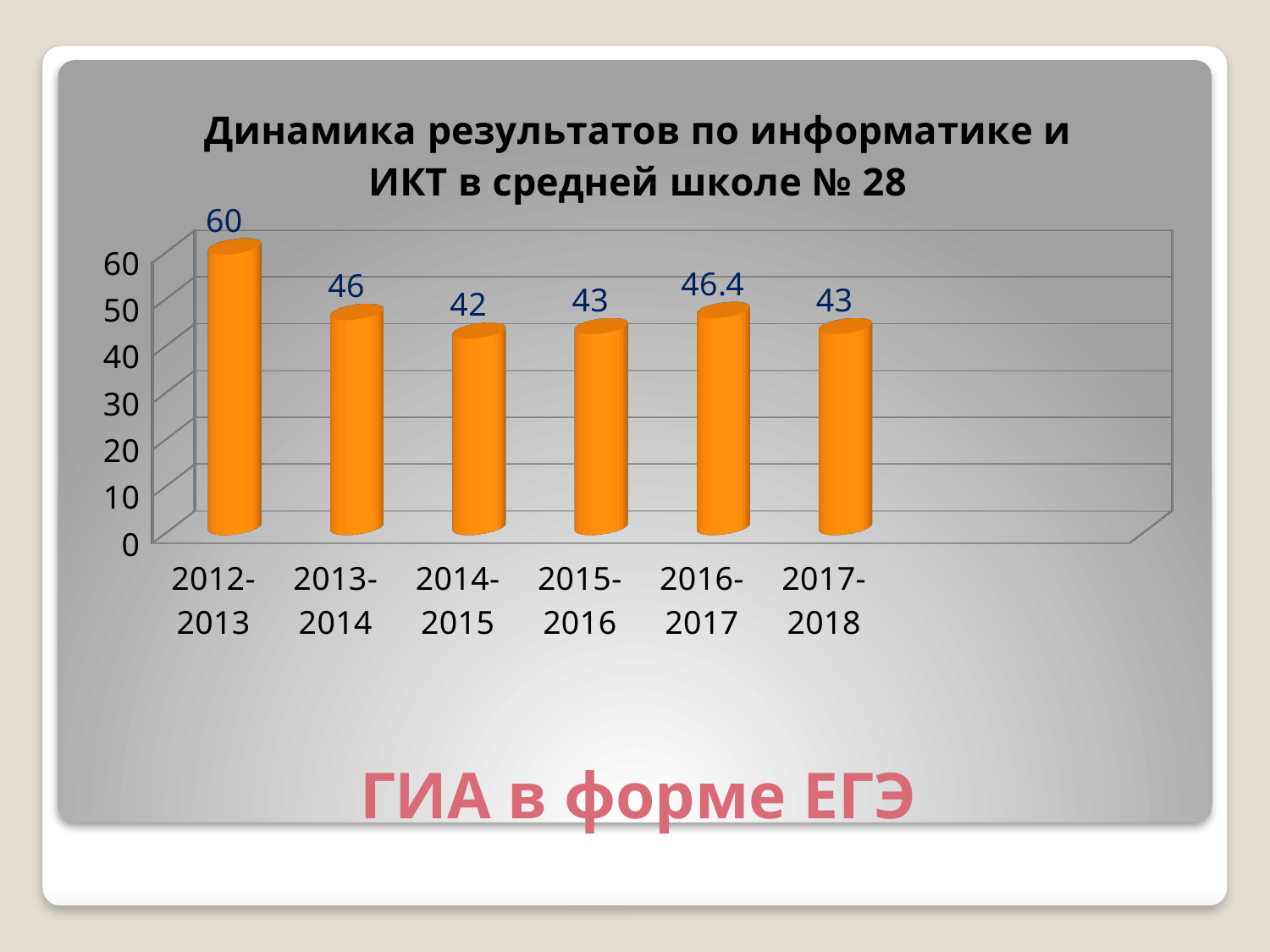
Is the value for 2012-2013 greater or less than 50? greater Which year has the highest value? 2012-2013 What is the value for 2012-2013? 60 Which year has the lowest value? 2014-2015 What is the difference between the values for 2012-2013 and 2013-2014? 14 How many years are shown on the x axis? 6 What kind of chart is this? bar chart Which is larger, the value for 2013-2014 or the value for 2015-2016? 2013-2014 What is the value for 2014-2015? 42 What is the title of the chart? Динамика результатов по информатике и ИКТ в средней школе № 28 What is the difference between the values for 2016-2017 and 2017-2018? 3.4 What is the value for 2016-2017? 46.4